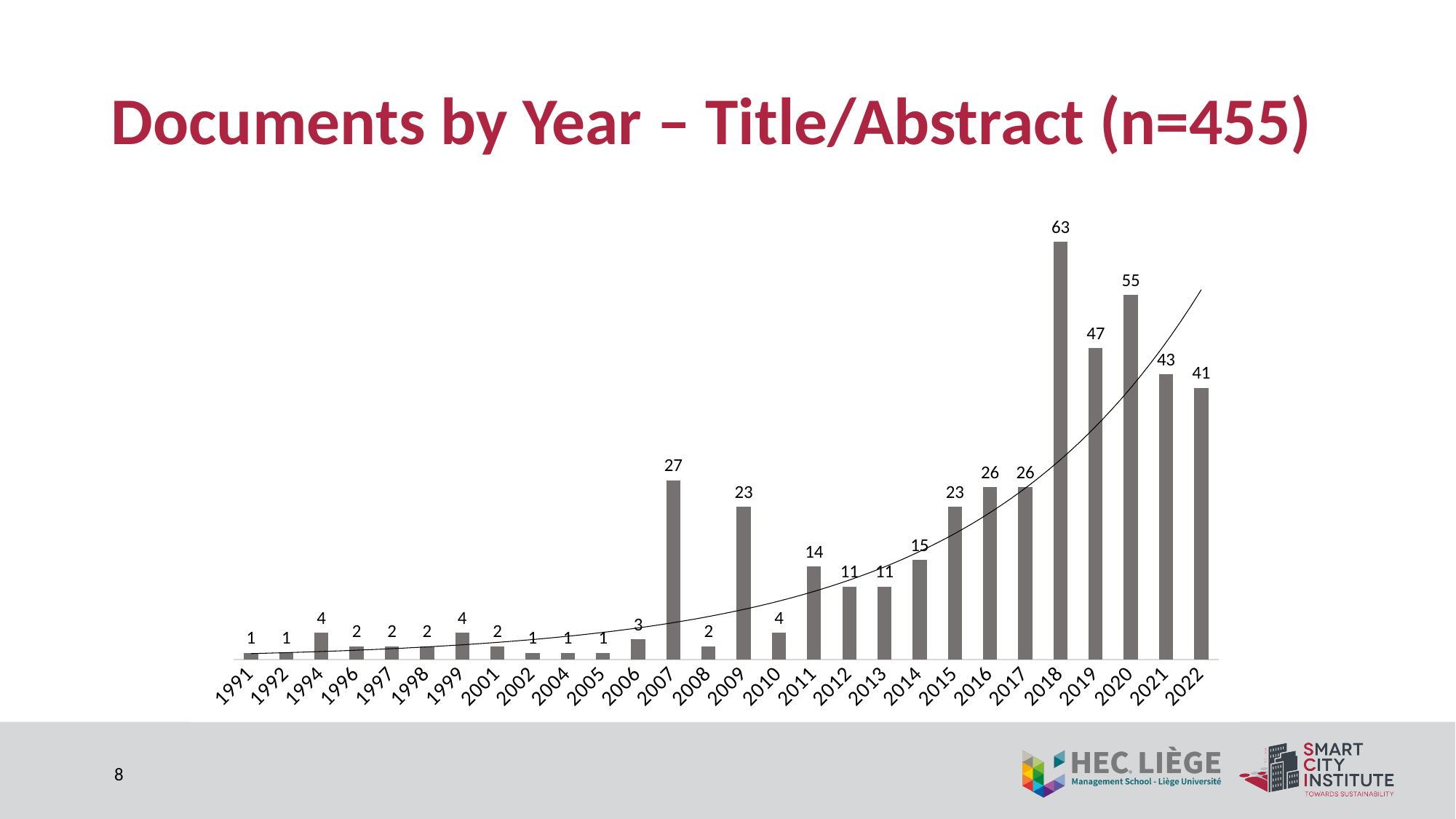
What kind of chart is this? Bar chart What is the difference between the values for 2018 and 2020? 8 What is the value for 2020? 55 Which year has the highest number of documents? 2018 What is the value for 2011? 14 How many years are shown on the x axis? 28 What is the difference between the values for 2019 and 2021? 4 How many documents are shown for 2018? 63 What is the value for 2007? 27 Do the values generally rise or fall from 1991 to 2022? Rise Which is larger, the value for 2014 or the value for 2015? 2015 Which is larger, the value for 2007 or the value for 2009? 2007